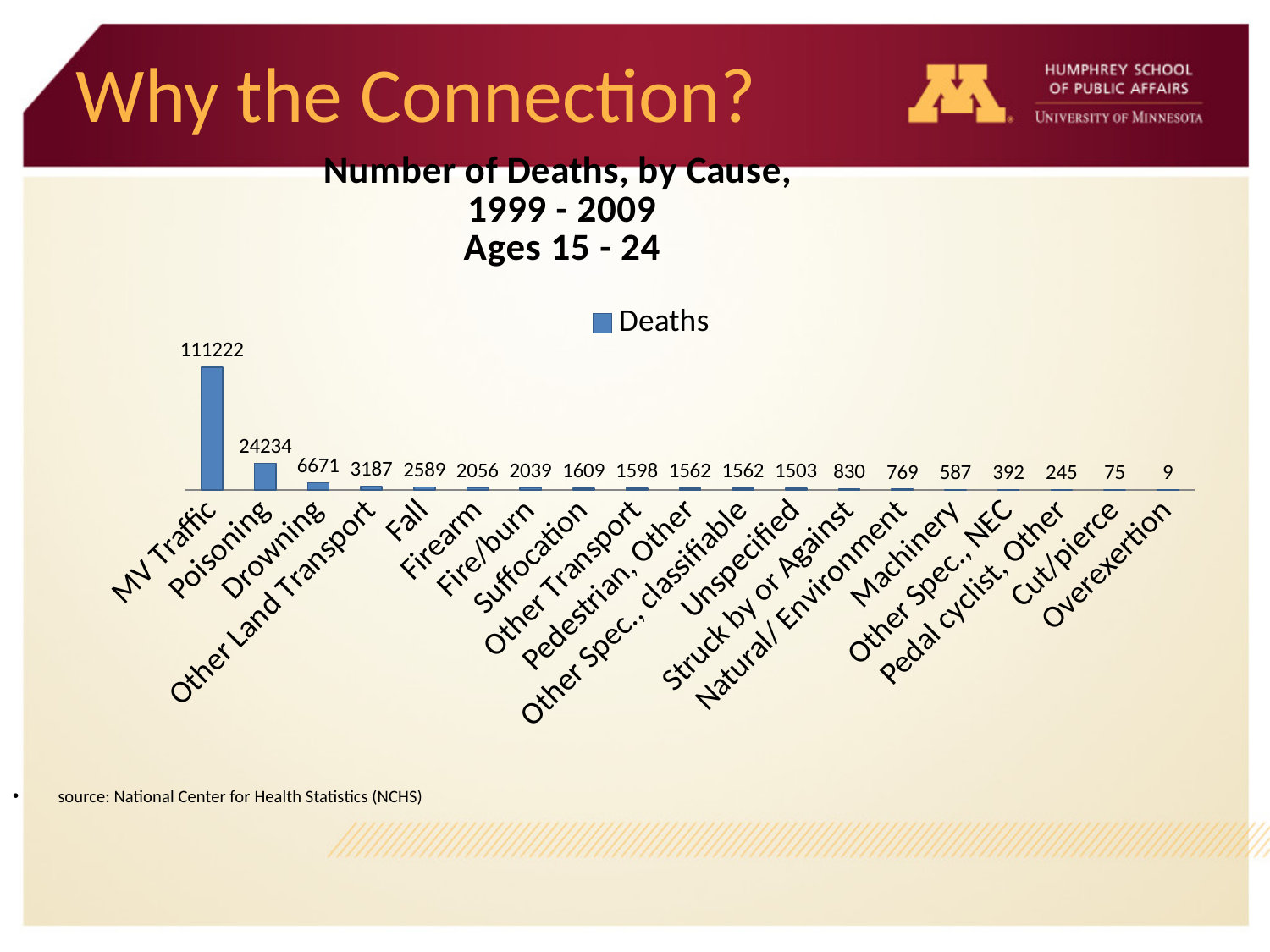
What is the value shown for Drowning? 6671 How many causes of death are shown on the chart? 19 How many deaths are shown for Pedal cyclist, Other? 245 What is the difference in deaths between MV Traffic and Poisoning? 86988 Which cause has the highest number of deaths? MV Traffic Which cause has the lowest number of deaths? Overexertion What is the number of deaths for Poisoning? 24234 What is the difference in deaths between Firearm and Fire/burn? 17 Which has more deaths, Fall or Suffocation? Fall What type of chart is shown on the slide? Bar chart How many deaths are shown for MV Traffic? 111222 What series name does the legend show? Deaths